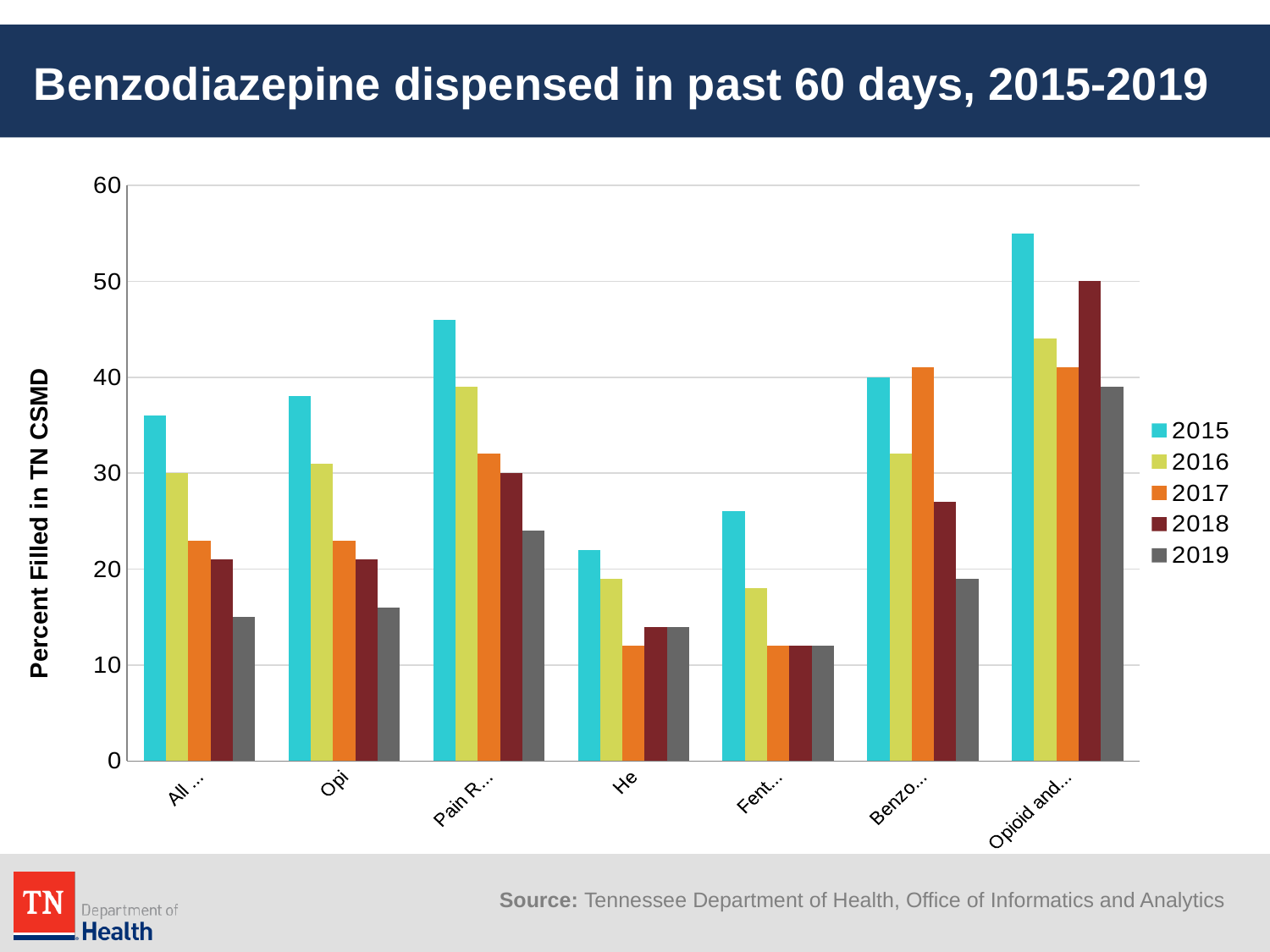
Which years does the legend list? 2015, 2016, 2017, 2018, 2019 Is the 2015 value for the category labeled "Opi" greater or less than 30? greater Is the 2015 value for the category labeled "Pain R..." greater or less than 40? greater What is the title of the y axis? Percent Filled in TN CSMD Is the 2019 value for the category labeled "He" greater or less than 20? less What kind of chart is shown on the slide? Bar chart How many series does the legend list? 5 In the category labeled "Opi", do the values rise or fall from 2015 to 2019? fall In the category labeled "Benzo...", which is larger, the 2017 value or the 2018 value? 2017 How many categories are shown along the x axis? 7 In the category labeled "Fent...", which year has the highest value? 2015